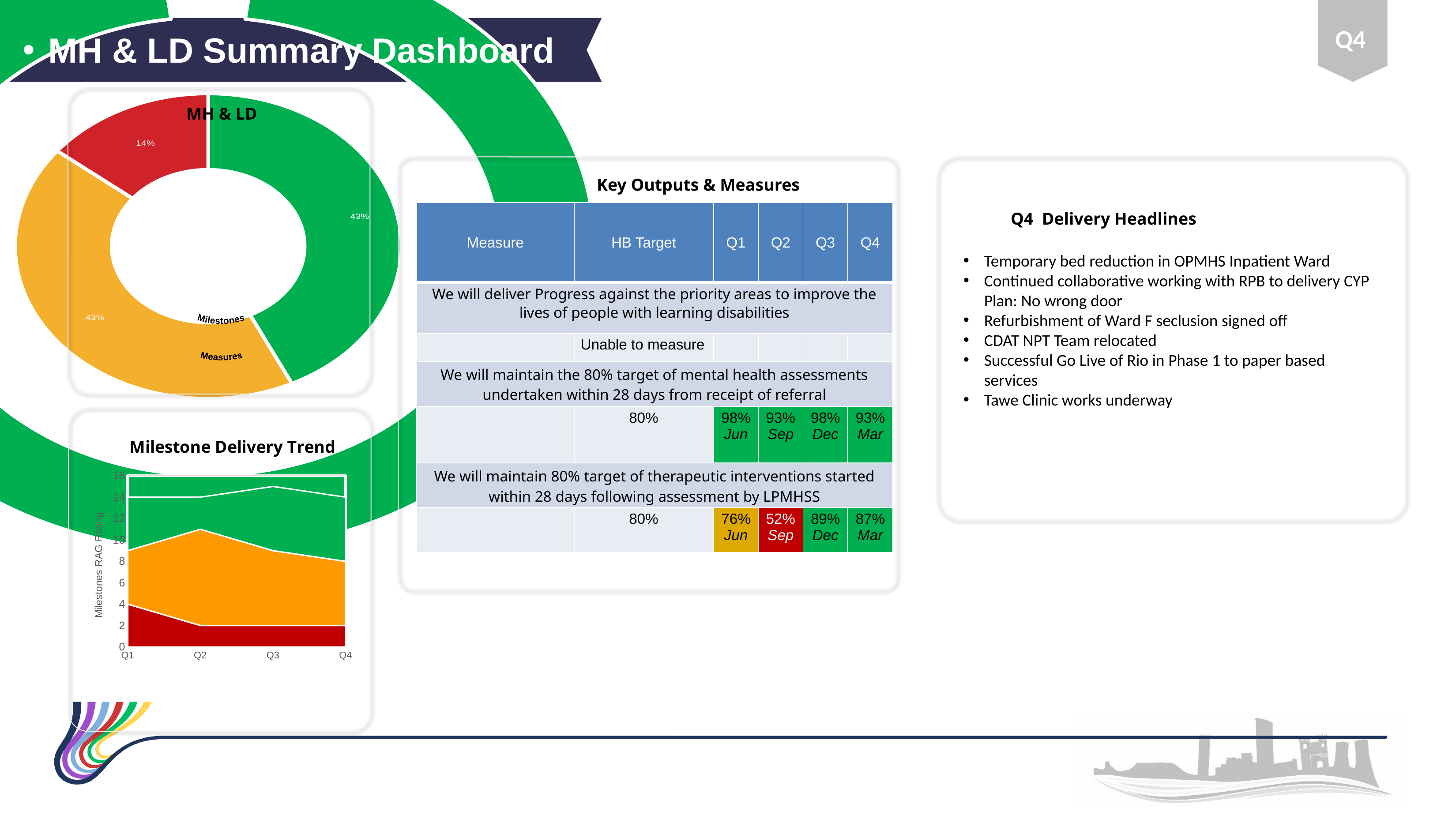
In the 'MH & LD' doughnut chart, what percentage is shown on the green slice? 43% In the 'MH & LD' doughnut chart, what percentage is shown on the red slice? 14% How many slices does the 'MH & LD' doughnut chart have? 3 What kind of chart is the 'Milestone Delivery Trend' chart? Stacked area chart What kind of chart is the 'MH & LD' chart at the top left of the slide? Doughnut (pie) chart What is the y-axis label of the 'Milestone Delivery Trend' chart? Milestones RAG Rating In the 'Milestone Delivery Trend' chart, is the red area's value at Q4 greater or less than 4? less How many quarters are shown on the x axis of the 'Milestone Delivery Trend' chart? 4 In the 'MH & LD' doughnut chart, which colour slice is the smallest? Red In the 'MH & LD' doughnut chart, what percentage is shown on the orange slice? 43% In the 'Milestone Delivery Trend' chart, is the red area's value at Q1 greater or less than 2? greater In the 'MH & LD' doughnut chart, what is the difference between the green slice's share and the red slice's share? 29%